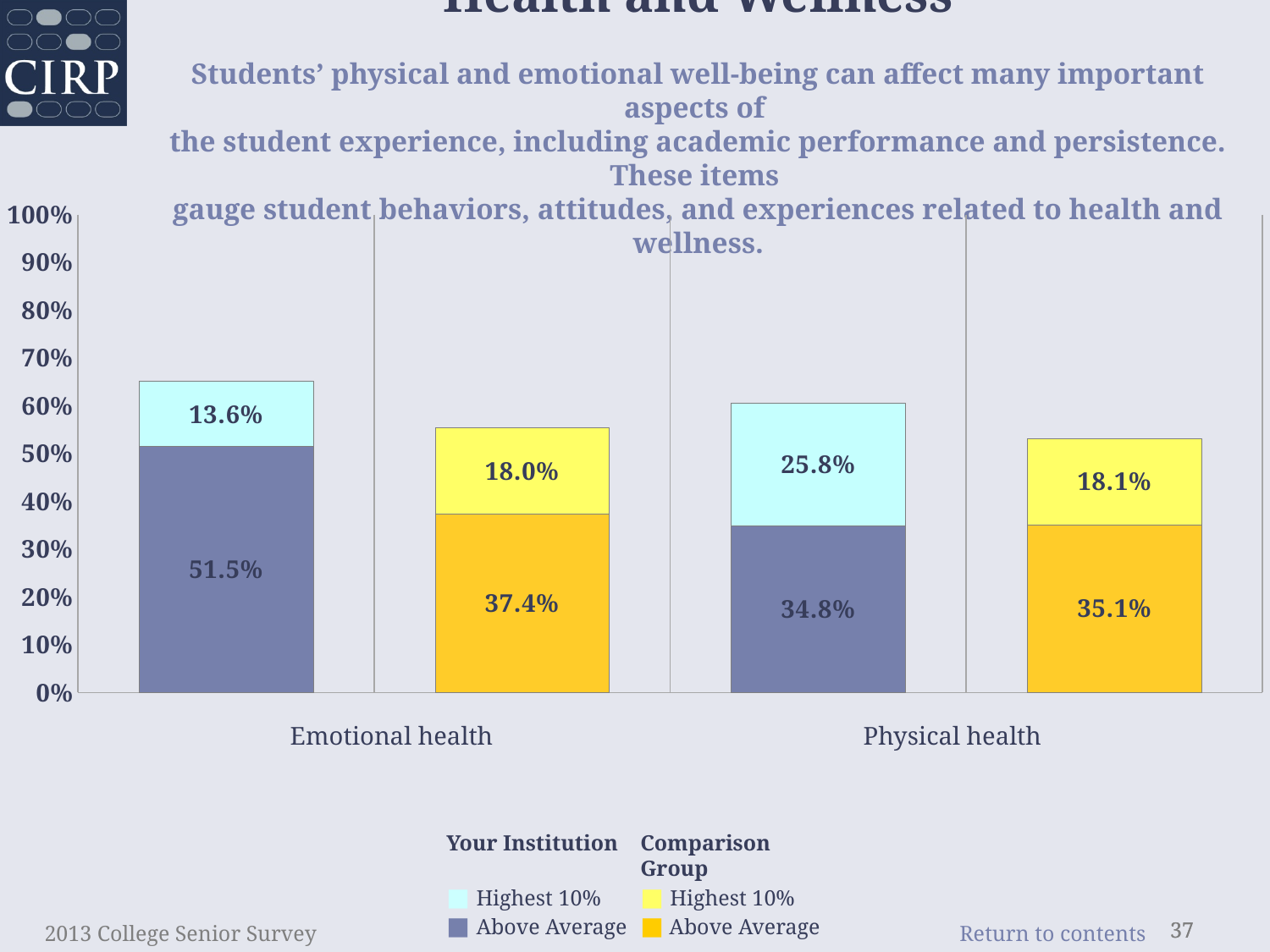
What is the 'Highest 10%' value for Your Institution in the Physical health category? 25.8% What is the total of the stacked bar for the Comparison Group in the Physical health category? 53.2% What is the difference between the 'Above Average' values for Your Institution and the Comparison Group in the Emotional health category? 14.1% How many categories are shown on the x axis? 2 What kind of chart is shown on the slide? Stacked bar chart Which stacked bar is the tallest on the chart? Your Institution, Emotional health Which is larger in the Physical health category: the 'Highest 10%' value for Your Institution or for the Comparison Group? Your Institution What is the total of the stacked bar for Your Institution in the Emotional health category? 65.1% How many series does the legend list? 4 What is the 'Above Average' value for Your Institution in the Emotional health category? 51.5% What is the 'Highest 10%' value for the Comparison Group in the Physical health category? 18.1% What is the 'Above Average' value for the Comparison Group in the Emotional health category? 37.4%